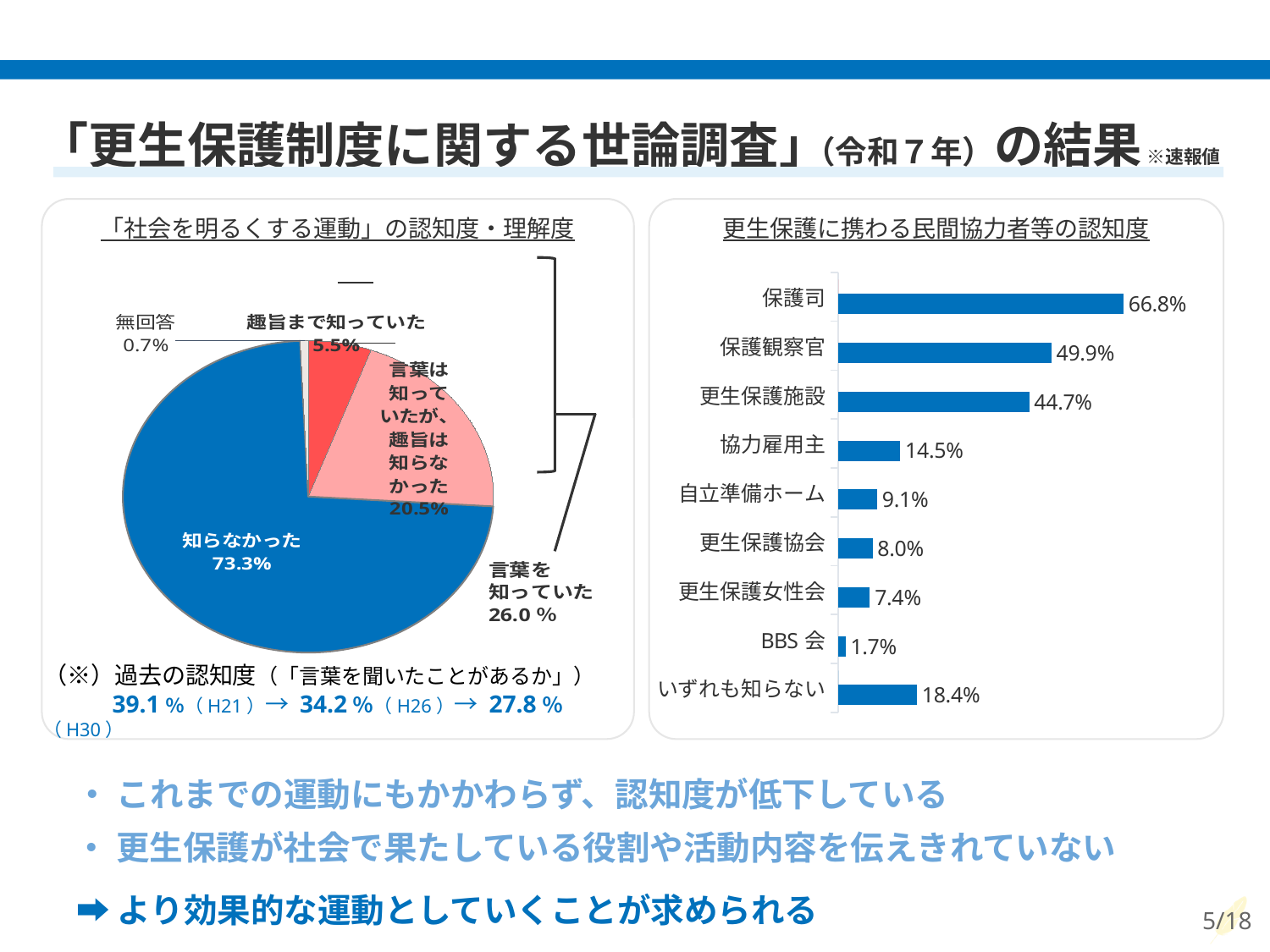
What kind of chart is the chart on the left side of the slide? Pie chart In the pie chart titled 「社会を明るくする運動」の認知度・理解度, what is the value for 趣旨まで知っていた? 5.5% What kind of chart is the chart on the right side of the slide? Bar chart How many categories are shown in the bar chart titled 更生保護に携わる民間協力者等の認知度? 9 In the pie chart titled 「社会を明るくする運動」の認知度・理解度, what share does 知らなかった have? 73.3% In the bar chart titled 更生保護に携わる民間協力者等の認知度, what is the value for 協力雇用主? 14.5% In the bar chart titled 更生保護に携わる民間協力者等の認知度, which category has the highest value? 保護司 In the bar chart titled 更生保護に携わる民間協力者等の認知度, what is the difference between the values for 保護観察官 and 更生保護施設? 5.2% In the pie chart titled 「社会を明るくする運動」の認知度・理解度, which slice is the smallest? 無回答 In the bar chart titled 更生保護に携わる民間協力者等の認知度, what is the value for 保護司? 66.8% In the bar chart titled 更生保護に携わる民間協力者等の認知度, which category has the lowest value? BBS会 In the bar chart titled 更生保護に携わる民間協力者等の認知度, which is larger, the value for 自立準備ホーム or the value for 更生保護協会? 自立準備ホーム